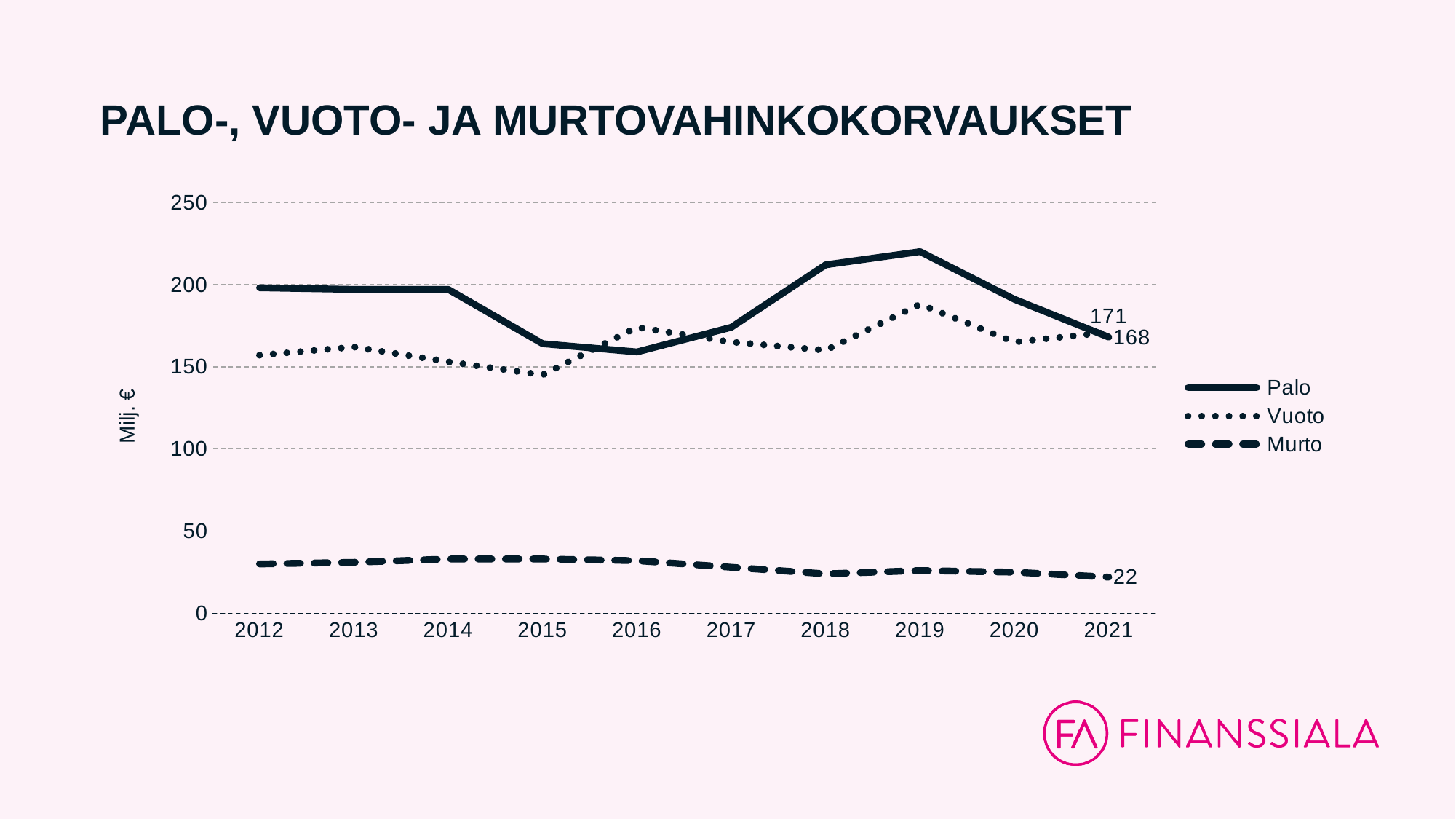
What unit is shown on the y axis? Milj. € Is the value for Palo in 2019 greater or less than 200? greater How many years are shown on the x axis? 10 How many series does the legend list? 3 Is the value for Vuoto in 2015 greater or less than 150? less In which year is the Vuoto series at its lowest? 2015 What kind of chart is shown on the slide? line chart Is the value for Murto in 2014 greater or less than 50? less What is the value for Murto in 2021? 22 Which series has the larger value in 2019, Palo or Vuoto? Palo Does the Murto series rise or fall from 2014 to 2021? fall In which year is the Palo series at its highest? 2019